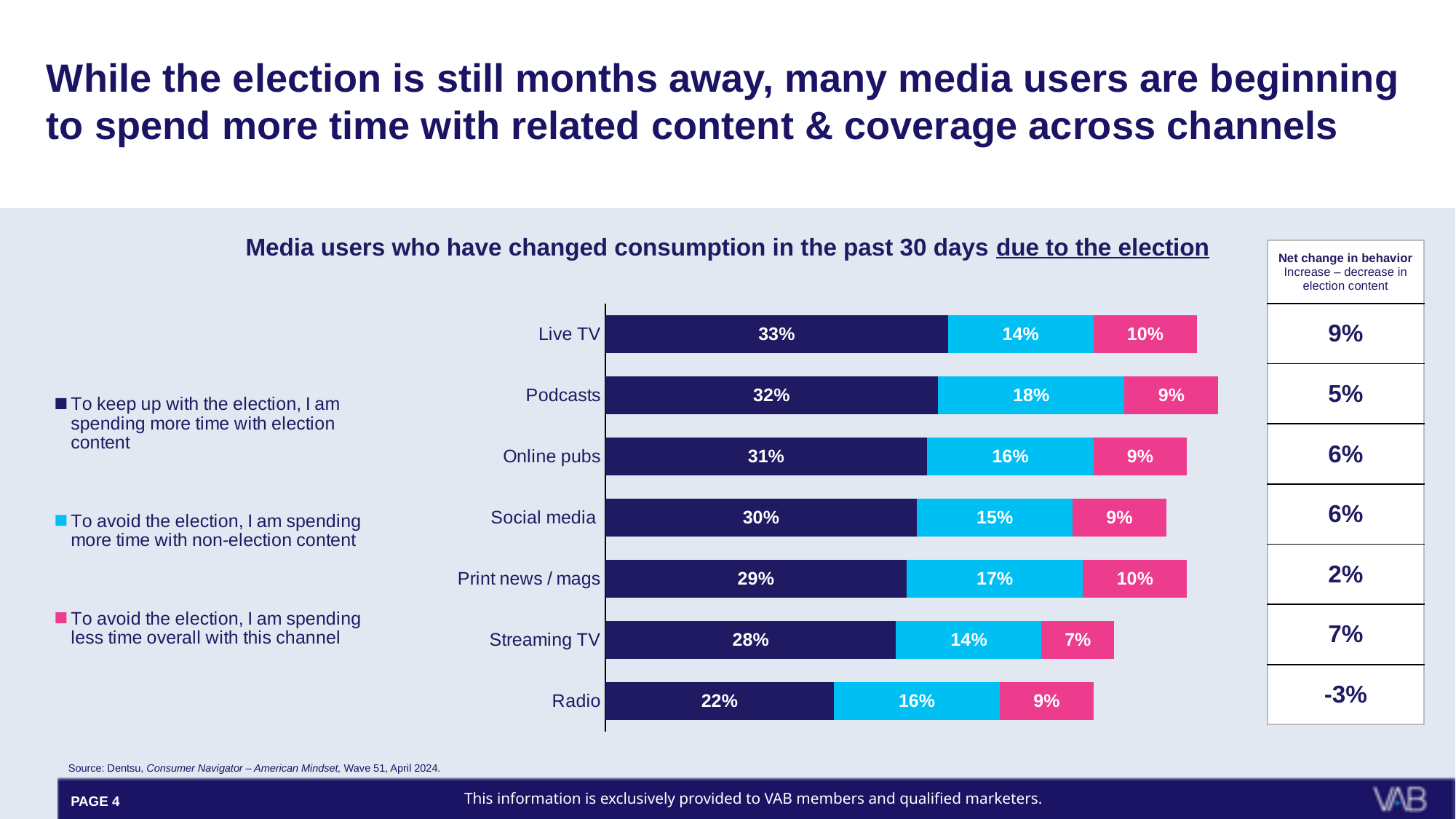
What is the total of the three segments for the Print news / mags bar? 56% How many channels are shown in the chart? 7 Which channel has the highest share of users spending more time with election content? Live TV How many series does the legend list? 3 What percentage of Podcasts users say they are spending more time with non-election content to avoid the election? 18% What is the net change in behavior shown for Radio? -3% Which is larger: the share of Podcasts users or Social media users spending more time with non-election content to avoid the election? Podcasts What percentage of Live TV users say they are spending more time with election content to keep up with the election? 33% What percentage of Streaming TV users say they are spending less time overall with this channel to avoid the election? 7% What kind of chart is shown on the slide? Stacked bar chart What is the difference between the share of Live TV users and Radio users spending more time with election content? 11% Which channel has the lowest share of users spending more time with election content? Radio